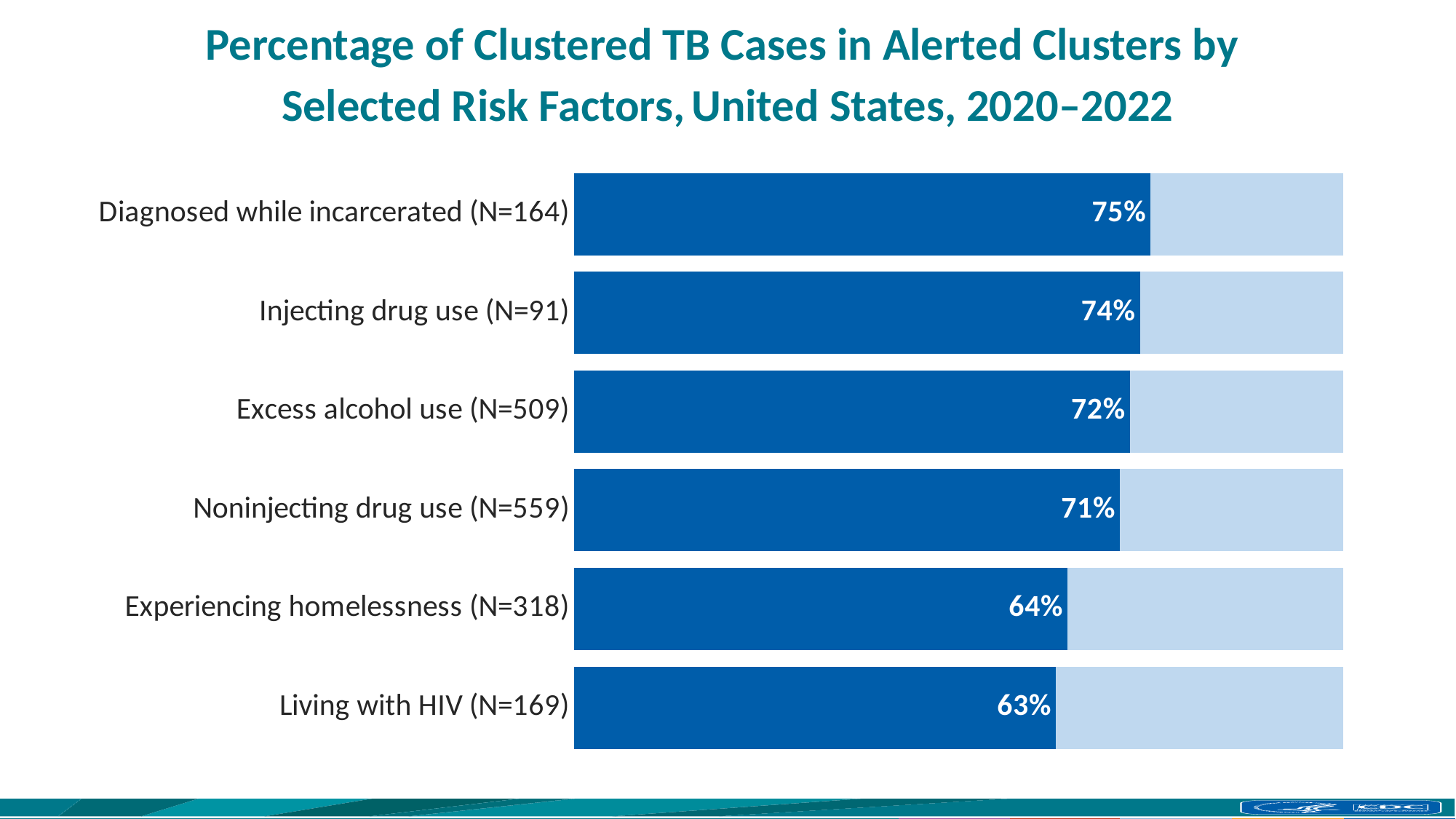
What percentage is shown for 'Experiencing homelessness'? 64% What percentage is shown for 'Living with HIV'? 63% What percentage of clustered TB cases were in alerted clusters for the 'Diagnosed while incarcerated' risk factor? 75% How many risk factor categories are shown in the chart? 6 Which has a higher percentage: 'Injecting drug use' or 'Noninjecting drug use'? Injecting drug use What is the difference in percentage points between 'Diagnosed while incarcerated' and 'Living with HIV'? 12 Which risk factor has the highest percentage of clustered TB cases in alerted clusters? Diagnosed while incarcerated Which risk factor has the lowest percentage of clustered TB cases in alerted clusters? Living with HIV What is the N value shown for 'Noninjecting drug use'? 559 What percentage is shown for 'Excess alcohol use'? 72% What is the difference in percentage points between 'Excess alcohol use' and 'Experiencing homelessness'? 8 What type of chart is shown on the slide? Bar chart